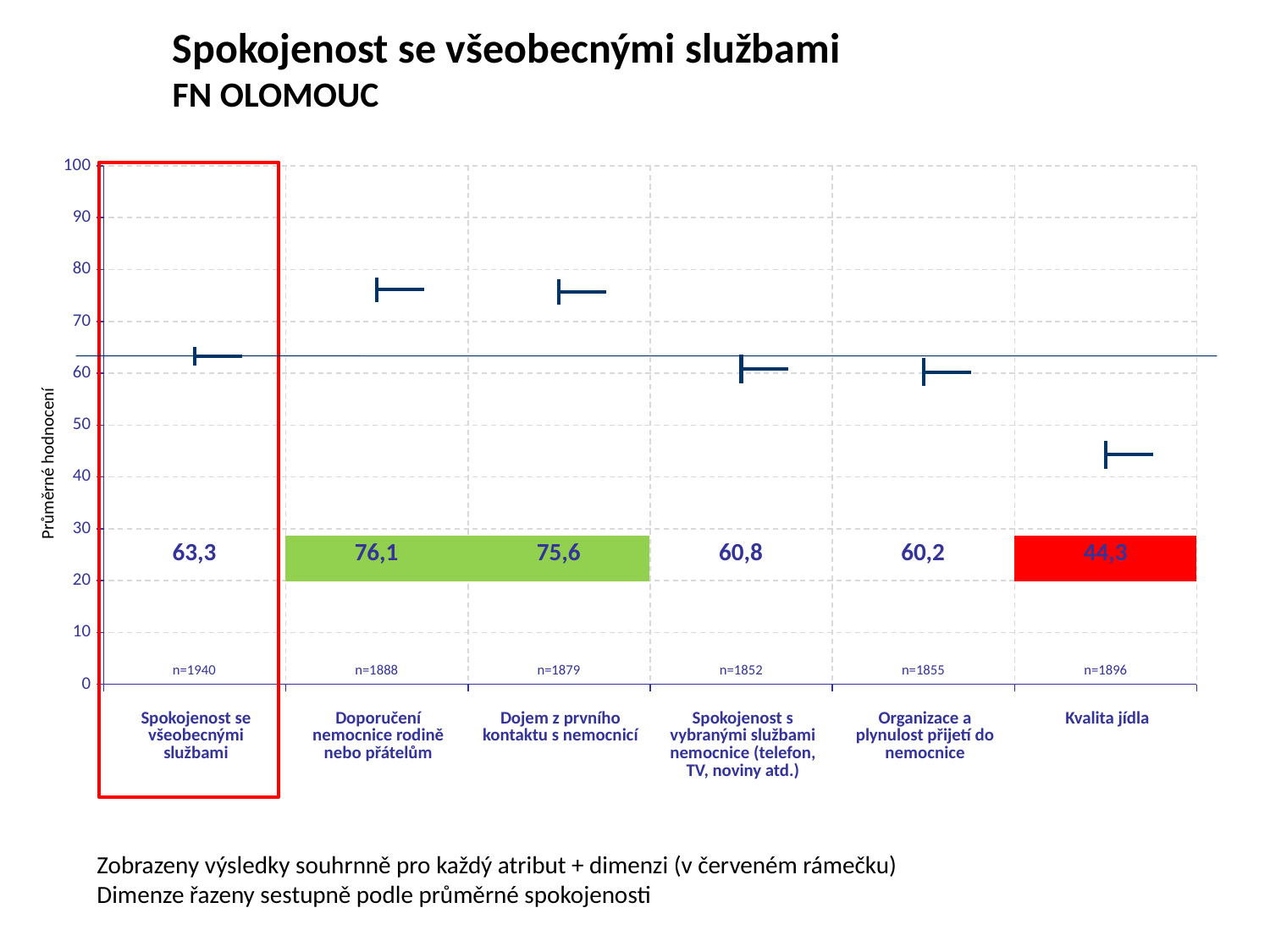
What is the average rating for 'Kvalita jídla'? 44,3 Which category is highlighted with a red frame on the chart? Spokojenost se všeobecnými službami Which has a higher average rating: 'Dojem z prvního kontaktu s nemocnicí' or 'Spokojenost s vybranými službami nemocnice (telefon, TV, noviny atd.)'? Dojem z prvního kontaktu s nemocnicí What is the difference between the average ratings for 'Doporučení nemocnice rodině nebo přátelům' and 'Kvalita jídla'? 31,8 What is the average rating for 'Organizace a plynulost přijetí do nemocnice'? 60,2 What is the sample size (n) shown for 'Kvalita jídla'? n=1896 What is the average rating for 'Spokojenost se všeobecnými službami'? 63,3 What is the label of the y axis of the chart? Průměrné hodnocení What is the average rating for 'Doporučení nemocnice rodině nebo přátelům'? 76,1 Which category has the highest average rating? Doporučení nemocnice rodině nebo přátelům How many categories are shown on the x axis of the chart? 6 Which category has the lowest average rating? Kvalita jídla